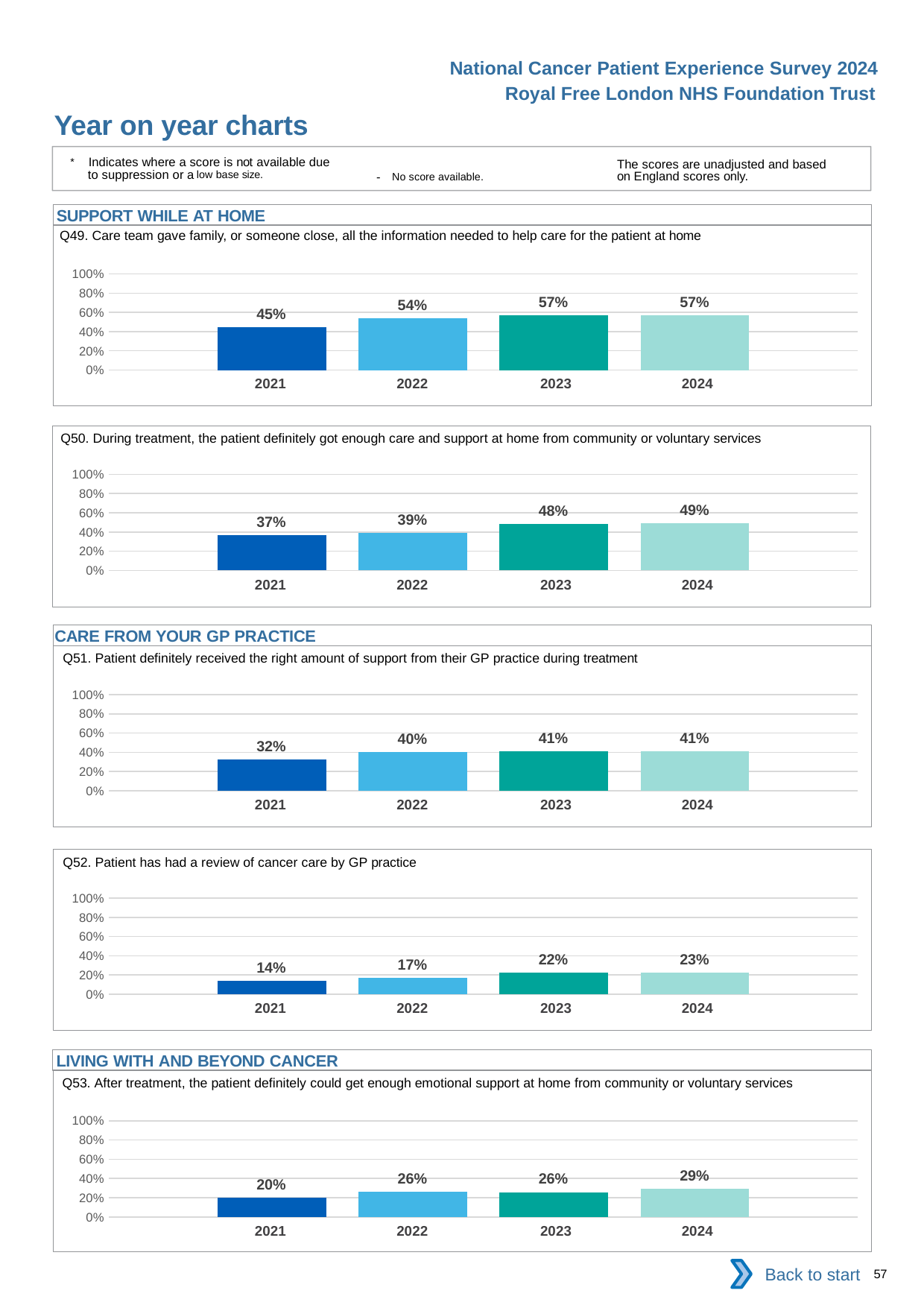
In the Q49 chart, what is the value for 2021? 45% What kind of chart is the Q52 chart? bar chart In the Q52 chart, what is the difference between the 2024 and 2021 values? 9% Which section heading appears above the Q53 chart? LIVING WITH AND BEYOND CANCER In the Q53 chart, what is the value for 2024? 29% In the Q51 chart, what is the difference between the 2022 and 2021 values? 8% In the Q51 chart, what is the value for 2023? 41% In the Q49 chart, how many years are plotted? 4 In the Q52 chart, which year has the lowest value? 2021 In the Q50 chart, which year has the highest value? 2024 In the Q53 chart, do the values generally rise or fall from 2021 to 2024? rise In the Q50 chart, is the value for 2023 larger or smaller than the value for 2022? larger